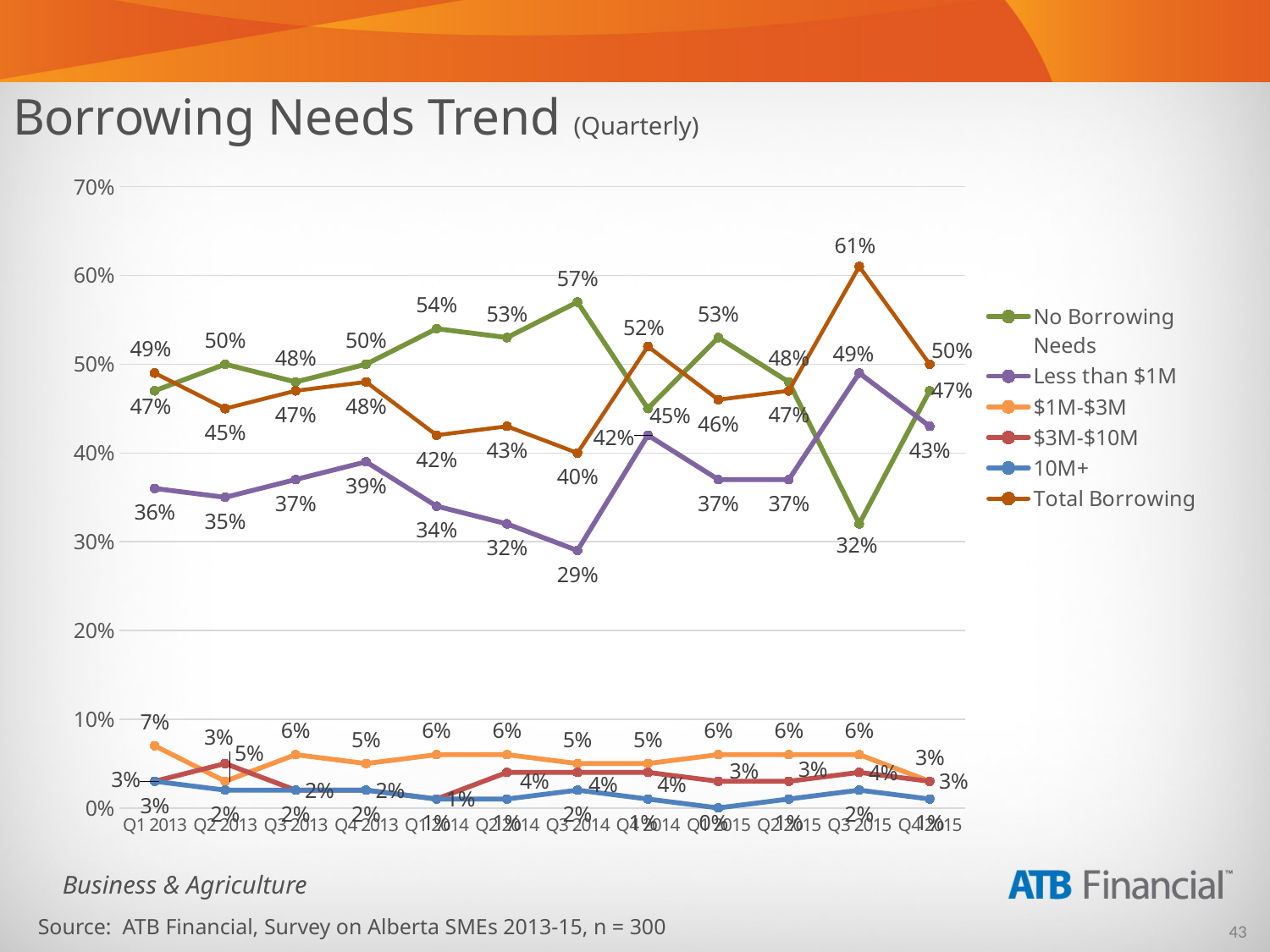
What kind of chart is shown on the slide? line chart In which quarter is Less than $1M at its lowest? Q3 2014 What is the value for Total Borrowing in Q3 2015? 61% In which quarter does Total Borrowing reach its highest value? Q3 2015 How many series does the legend list? 6 How many quarters are plotted along the x axis? 12 In which quarter is No Borrowing Needs at its lowest? Q3 2015 What is the value for Less than $1M in Q3 2015? 49% In Q4 2014, which is larger: Total Borrowing or No Borrowing Needs? Total Borrowing Is the value for Total Borrowing in Q3 2015 greater or less than 60%? greater What is the difference between Total Borrowing and No Borrowing Needs in Q3 2015? 29 percentage points What is the value for No Borrowing Needs in Q3 2014? 57%